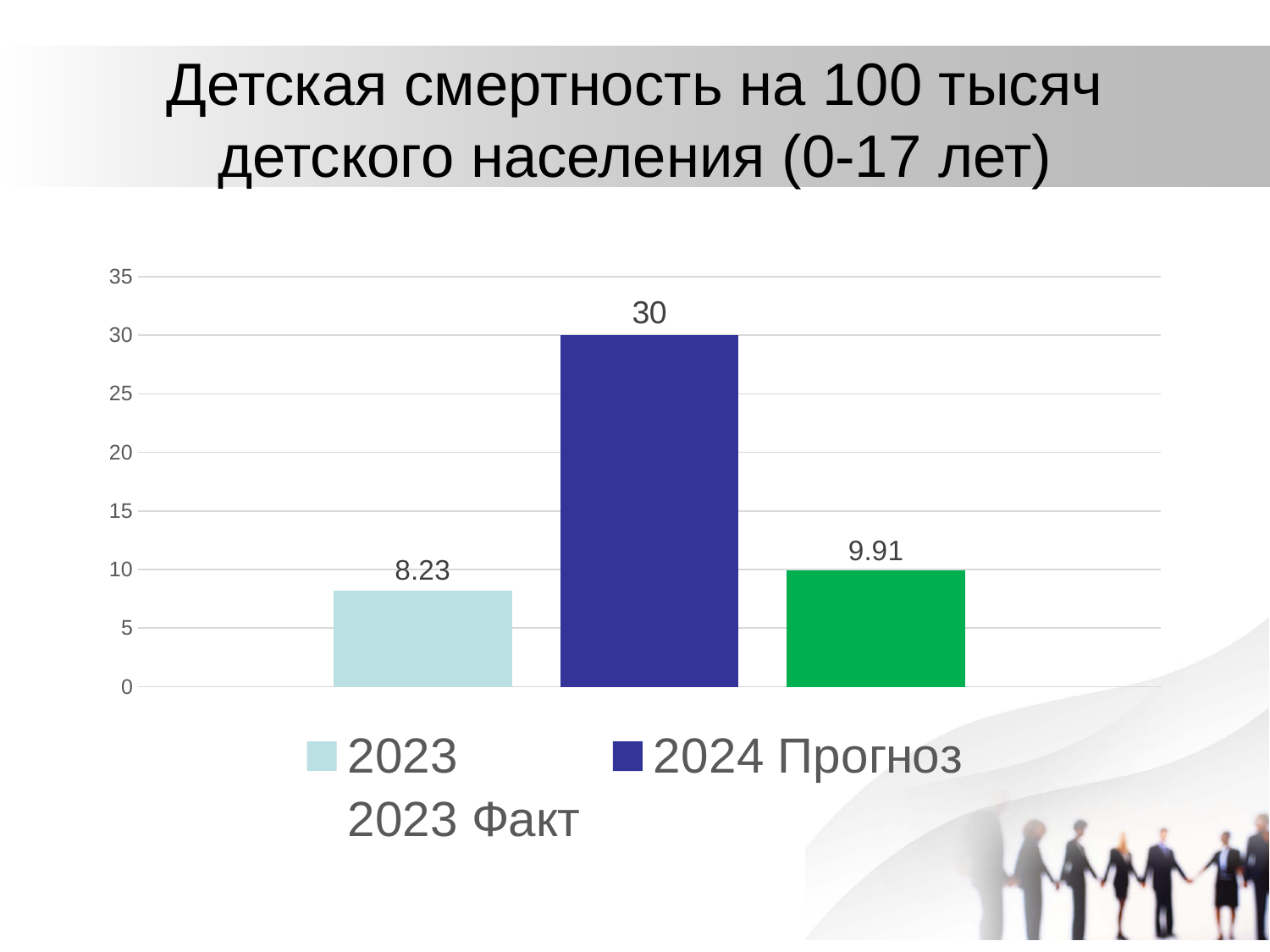
What is the difference between the 2024 Прогноз value and the 2023 Факт value? 20.09 What is the title of the slide? Детская смертность на 100 тысяч детского населения (0-17 лет) What is the difference between the 2023 Факт value and the 2023 value? 1.68 Which is larger, the 2023 Факт value or the 2023 value? 2023 Факт How many bars are plotted in the chart? 3 Which series has the lowest value? 2023 Which series has the highest value? 2024 Прогноз Is the value for 2024 Прогноз greater or less than 25? greater What is the value of the 2023 Факт bar (green)? 9.91 What is the value of the 2024 Прогноз bar? 30 What type of chart is shown on the slide? bar chart What is the value of the 2023 bar (light blue)? 8.23